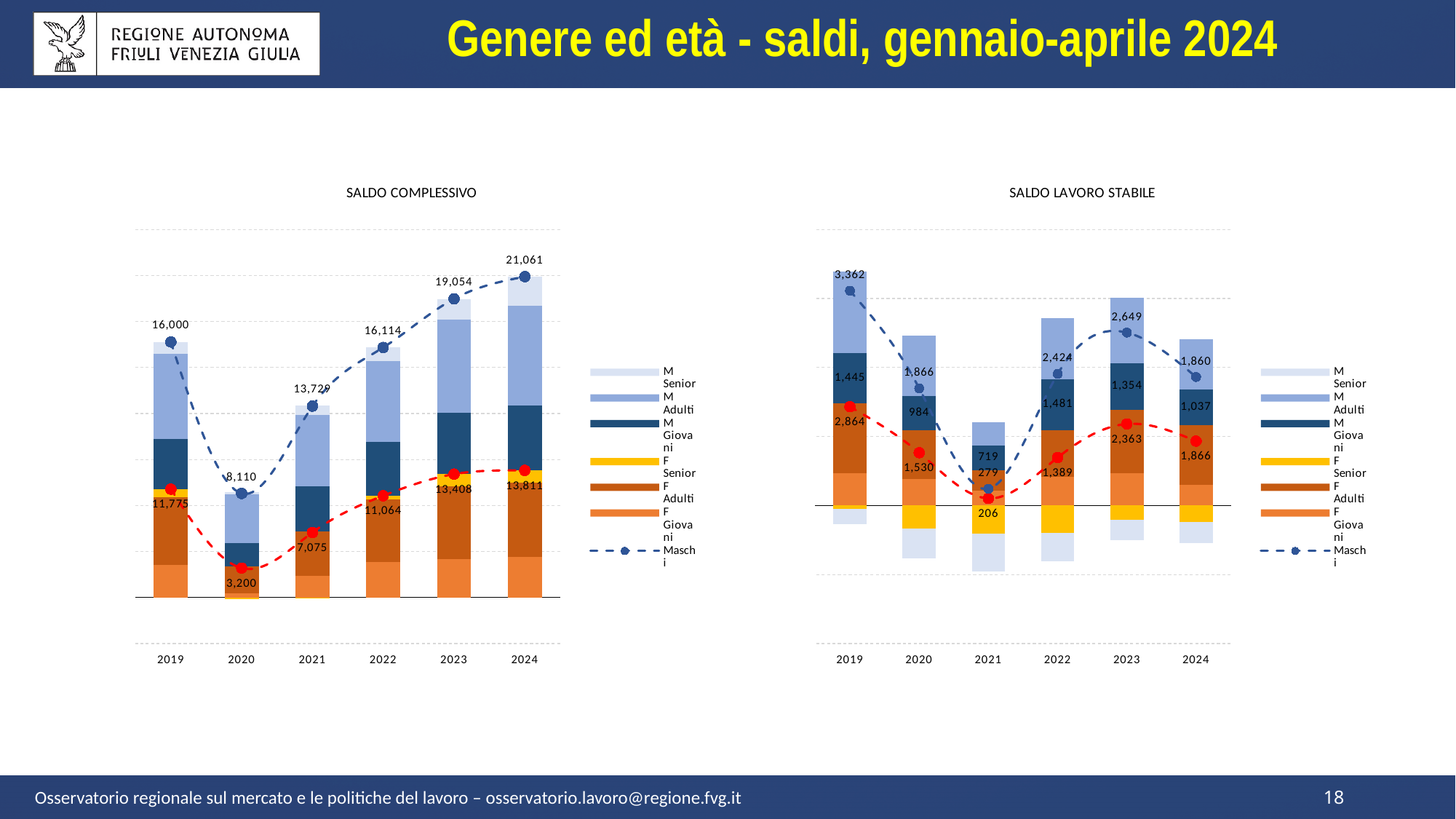
In the SALDO COMPLESSIVO chart, what is the value of the red dashed line in 2020? 3,200 In the SALDO COMPLESSIVO chart, which year has the lowest value on the Maschi line? 2020 In the SALDO LAVORO STABILE chart, what is the M Giovani value for 2022? 1,481 What kind of chart is the SALDO COMPLESSIVO chart? stacked bar chart with dashed lines In the SALDO COMPLESSIVO chart, what is the difference between the Maschi values for 2024 and 2019? 5,061 How many years are shown on the x axis of the SALDO LAVORO STABILE chart? 6 In the SALDO COMPLESSIVO chart, does the Maschi line rise or fall from 2020 to 2024? rise In the SALDO COMPLESSIVO chart, what is the value of the Maschi line in 2024? 21,061 In the SALDO LAVORO STABILE chart, what is the value of the Maschi line in 2021? 279 In the SALDO LAVORO STABILE chart, which year has the highest value on the Maschi line? 2019 In the SALDO LAVORO STABILE chart, what is the difference between the Maschi values for 2019 and 2024? 1,502 In the SALDO COMPLESSIVO chart, is the Maschi value larger in 2022 or in 2023? 2023